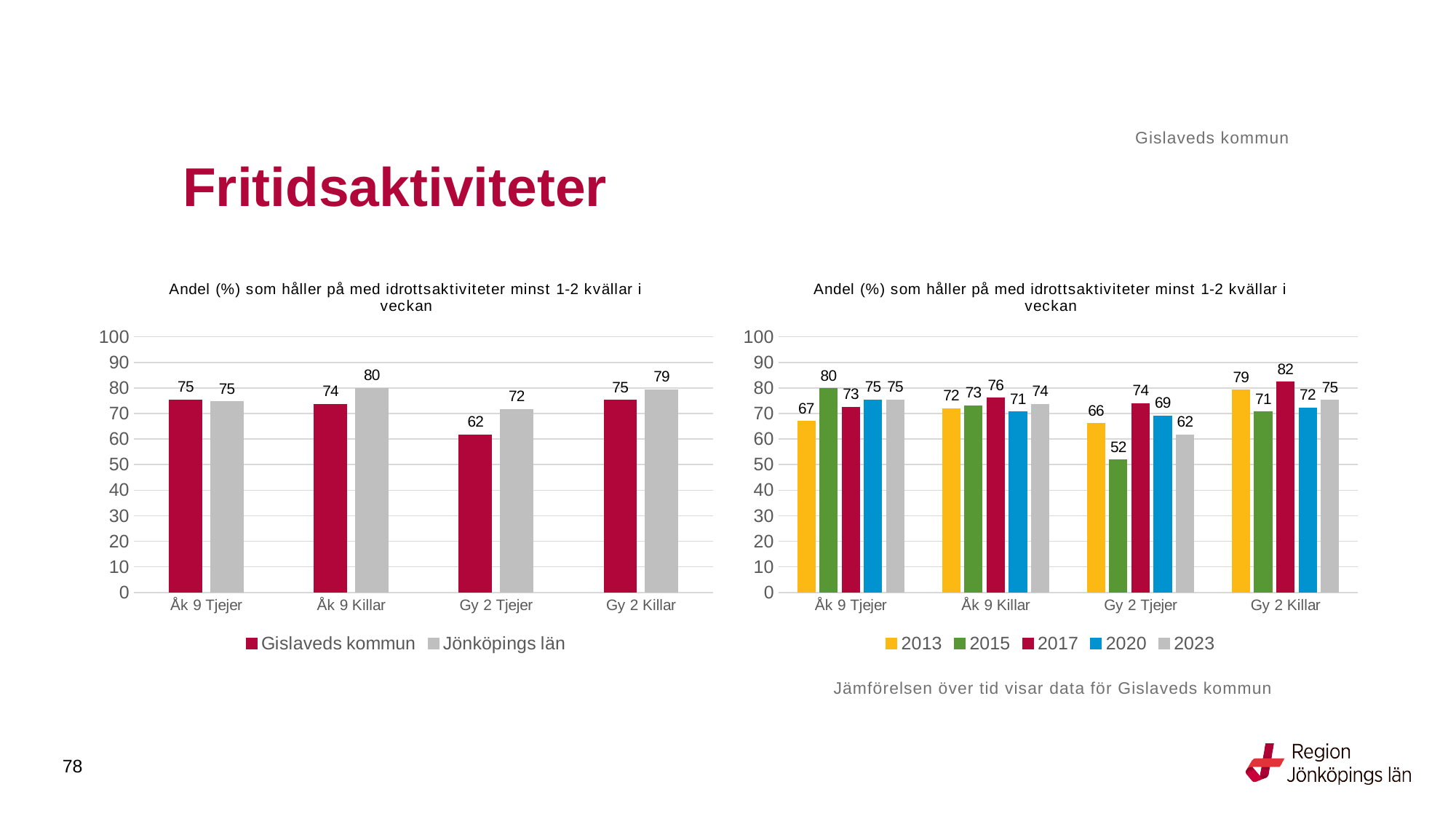
In the left chart, what is the value for Jönköpings län for Åk 9 Killar? 80 In the right chart, which is larger for Åk 9 Killar: the value for 2017 or the value for 2020? 2017 In the left chart, what is the difference between Jönköpings län and Gislaveds kommun for Gy 2 Tjejer? 10 In the right chart, how many series does the legend list? 5 In the left chart, what is the value for Gislaveds kommun for Gy 2 Tjejer? 62 In the right chart, what is the value for 2017 for Gy 2 Killar? 82 In the right chart, which year has the highest value for Åk 9 Tjejer? 2015 In the right chart, what is the difference between the 2013 and 2023 values for Åk 9 Tjejer? 8 In the left chart, which category has the lowest value for Gislaveds kommun? Gy 2 Tjejer In the left chart, how many series does the legend list? 2 What kind of chart is the right chart? Bar chart In the right chart, what is the value for 2015 for Gy 2 Tjejer? 52